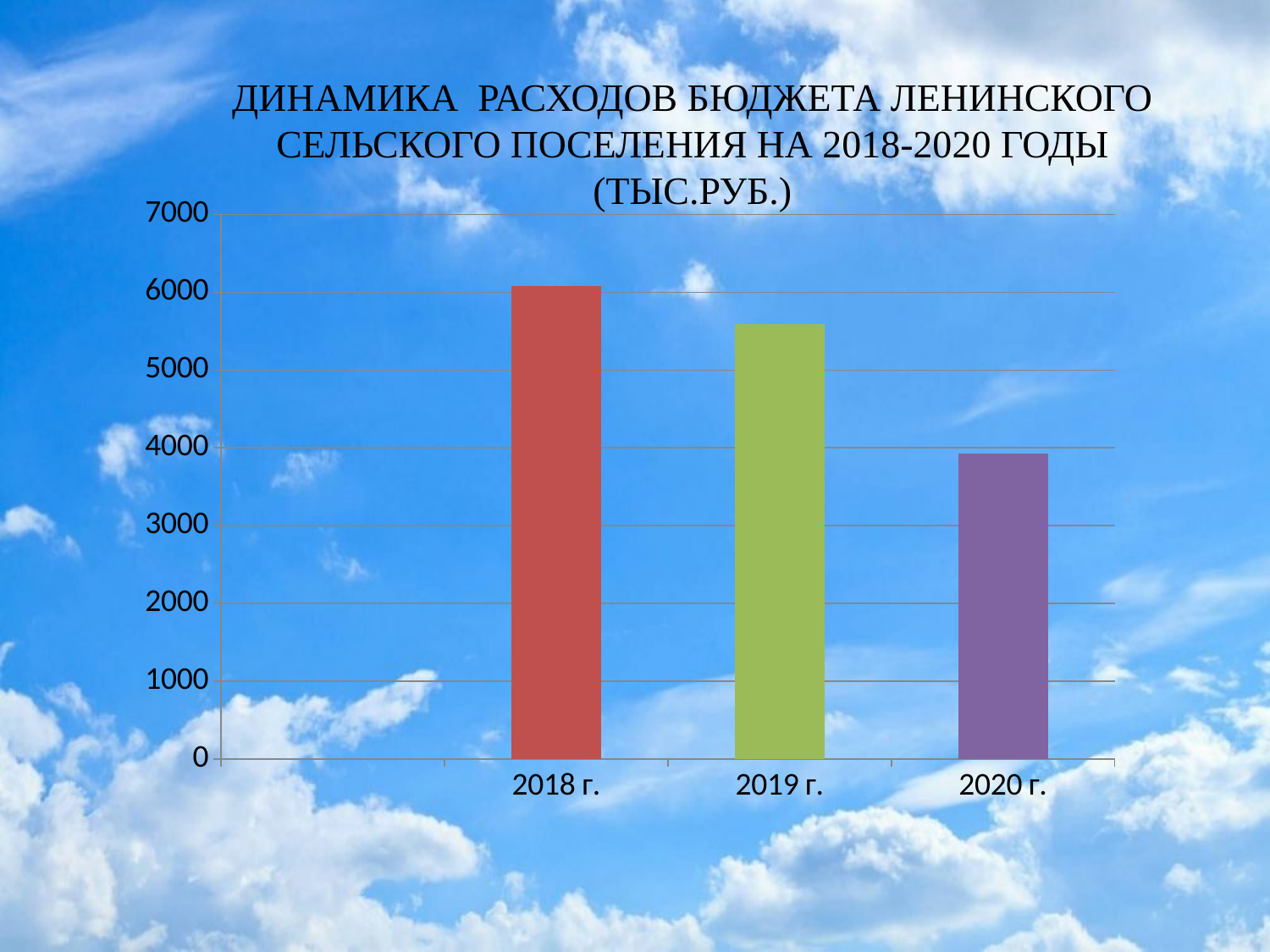
Is the value for 2018 г. greater or less than 5000? greater Which is larger, the value for 2019 г. or the value for 2020 г.? 2019 г. Which year has the highest budget expenditure? 2018 г. Is the value for 2019 г. greater or less than 6000? less Which is larger, the value for 2018 г. or the value for 2019 г.? 2018 г. Is the value for 2020 г. greater or less than 3000? greater What colour is the bar for 2020 г.? purple How many years (categories) are plotted on the chart? 3 Do the values rise or fall from 2018 г. to 2020 г.? fall What kind of chart is shown on the slide? bar chart In what units are the values on the chart expressed, according to the title? тыс.руб. Which year has the lowest budget expenditure? 2020 г.